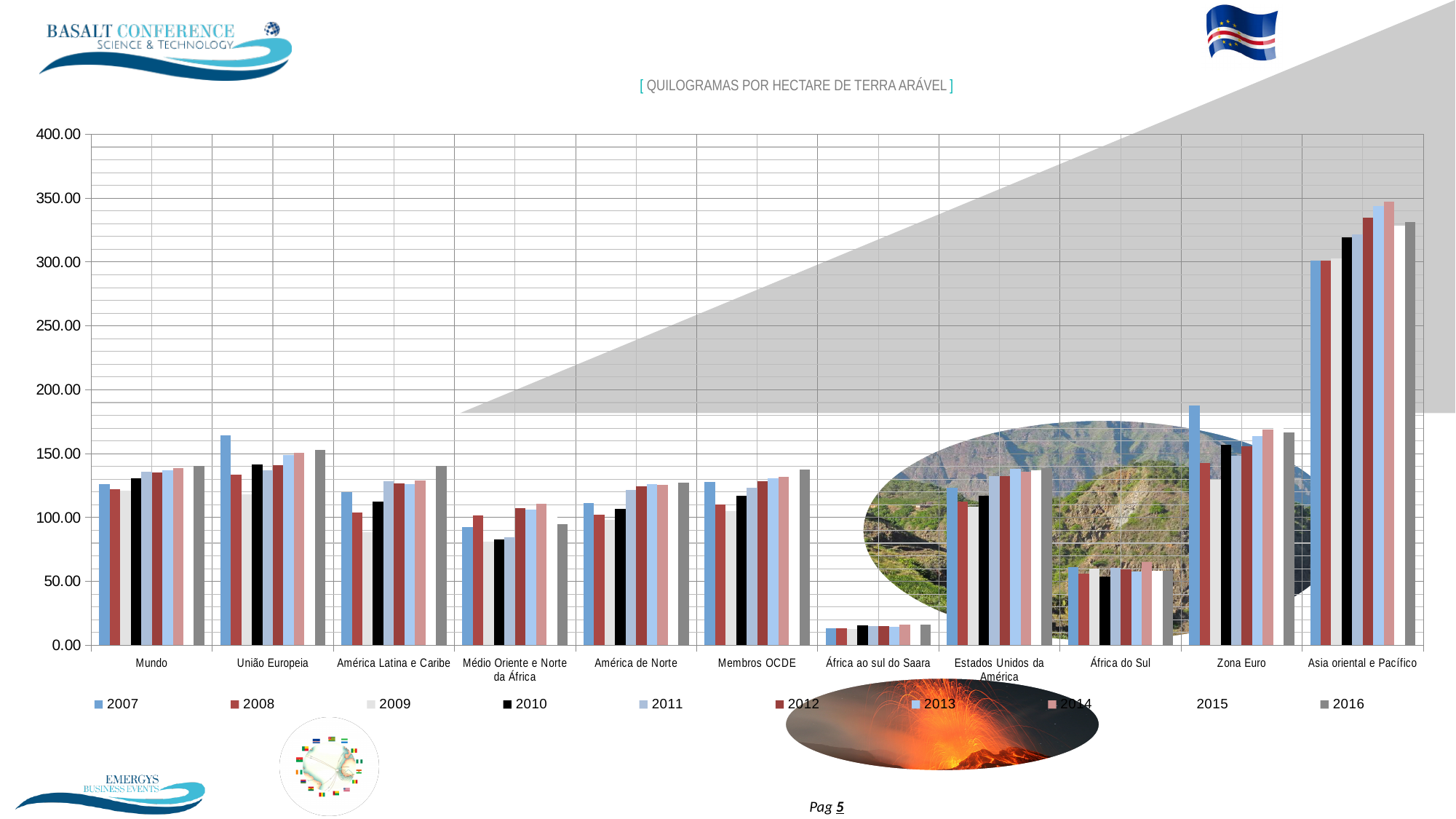
Which category has the highest values in the chart? Asia oriental e Pacífico Which has the larger 2010 value, Médio Oriente e Norte da África or América de Norte? América de Norte Is the 2007 value for União Europeia greater or less than 150? greater Is the 2007 value for África do Sul greater or less than 100? less Which category has the lowest values in the chart? África ao sul do Saara How many categories are shown along the x axis of the chart? 11 Is the 2016 value for África ao sul do Saara greater or less than 50? less Which has the larger 2007 value, Zona Euro or Mundo? Zona Euro How many series does the legend list? 10 What is the title of the chart? [ QUILOGRAMAS POR HECTARE DE TERRA ARÁVEL ] What kind of chart is shown on the slide? bar chart